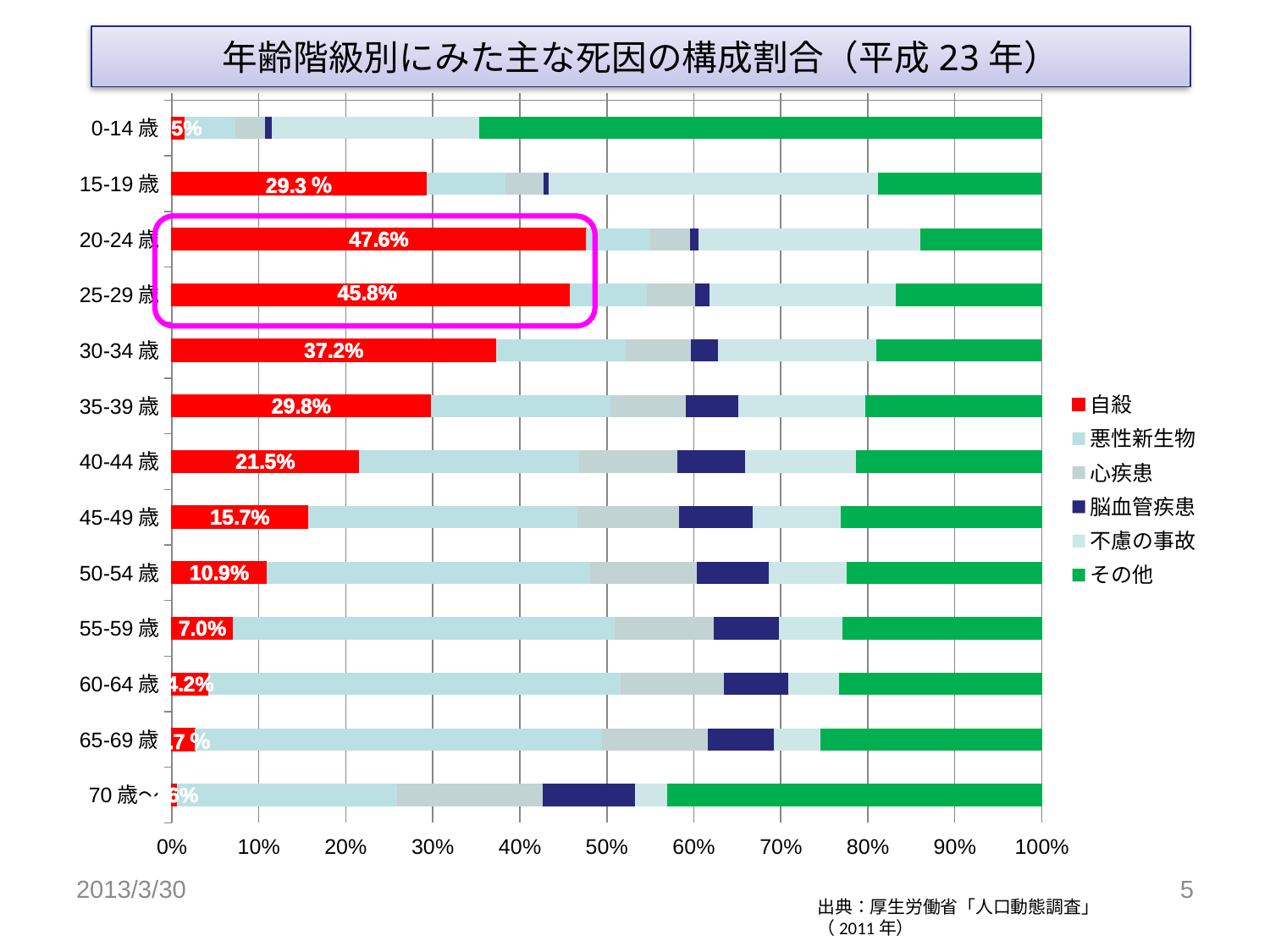
How many age groups are shown on the chart? 13 What is the suicide (自殺) share for the 45-49 歳 age group? 15.7% Is the その他 share for the 0-14 歳 age group greater or less than 60%? greater What kind of chart is shown on the slide? Stacked bar chart Which age group has the highest suicide (自殺) share? 20-24 歳 From the 20-24 歳 group to the 60-64 歳 group, does the suicide (自殺) share rise or fall? Fall What is the suicide (自殺) share for the 20-24 歳 age group? 47.6% How many series does the legend list? 6 What is the difference between the suicide shares of the 20-24 歳 and 25-29 歳 age groups? 1.8% Which has the larger suicide (自殺) share, 30-34 歳 or 35-39 歳? 30-34 歳 What is the title of the chart? 年齢階級別にみた主な死因の構成割合（平成 23 年） What is the suicide (自殺) share for the 55-59 歳 age group? 7.0%